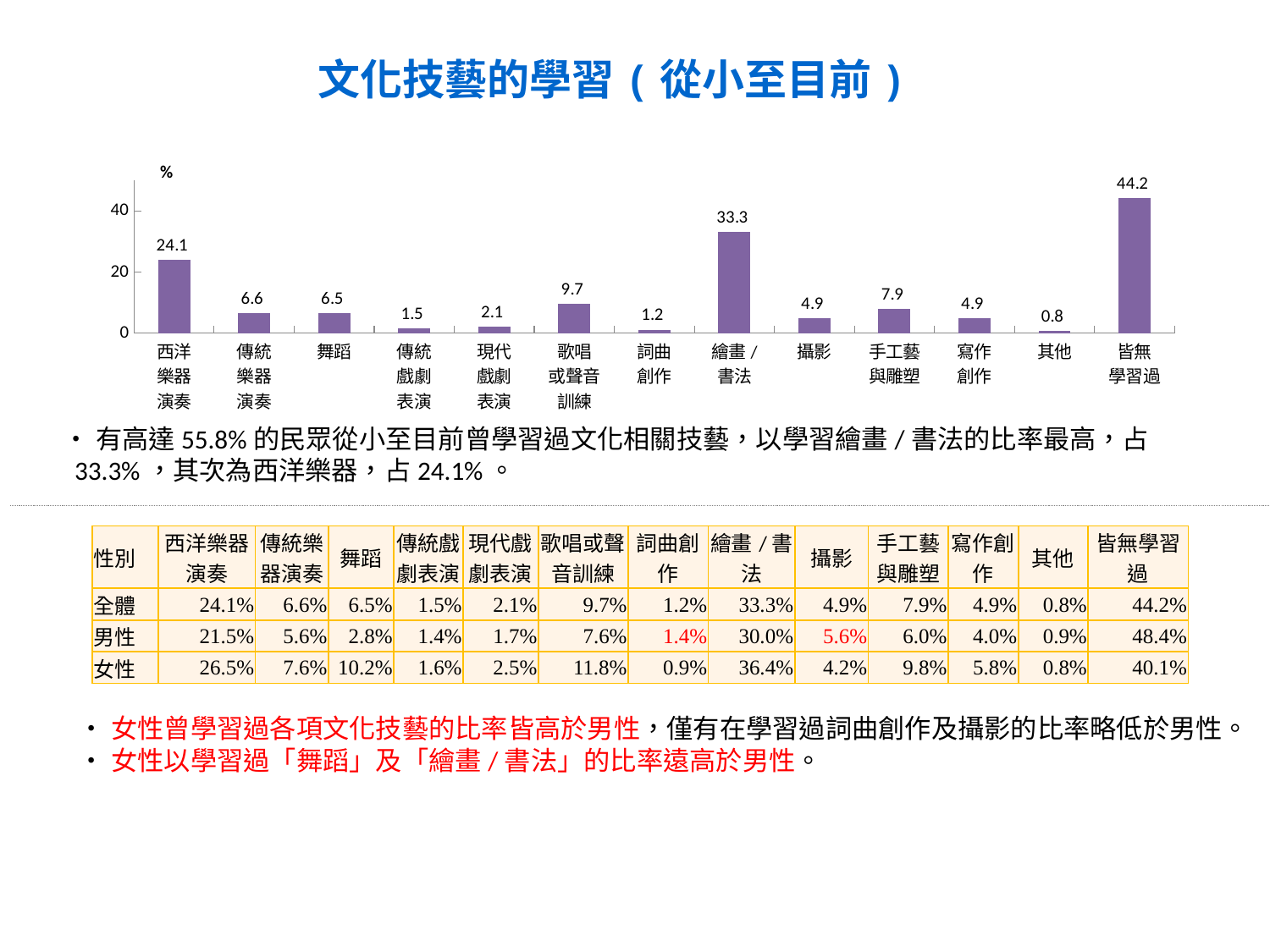
Is the value for 手工藝與雕塑 greater or less than 20? less What is the value for 歌唱或聲音訓練 in the chart? 9.7 Which category has the highest value in the chart? 皆無學習過 Which category has the lowest value in the chart? 其他 Which is larger, the value for 傳統樂器演奏 or the value for 舞蹈? 傳統樂器演奏 What is the value for 西洋樂器演奏 in the chart? 24.1 What type of chart is shown on the slide? bar chart What unit is indicated at the top of the vertical axis of the chart? % What is the difference between the values for 西洋樂器演奏 and 傳統樂器演奏? 17.5 What is the difference between the values for 皆無學習過 and 繪畫／書法? 10.9 What is the value for 繪畫／書法 in the chart? 33.3 How many categories are shown on the x axis of the chart? 13